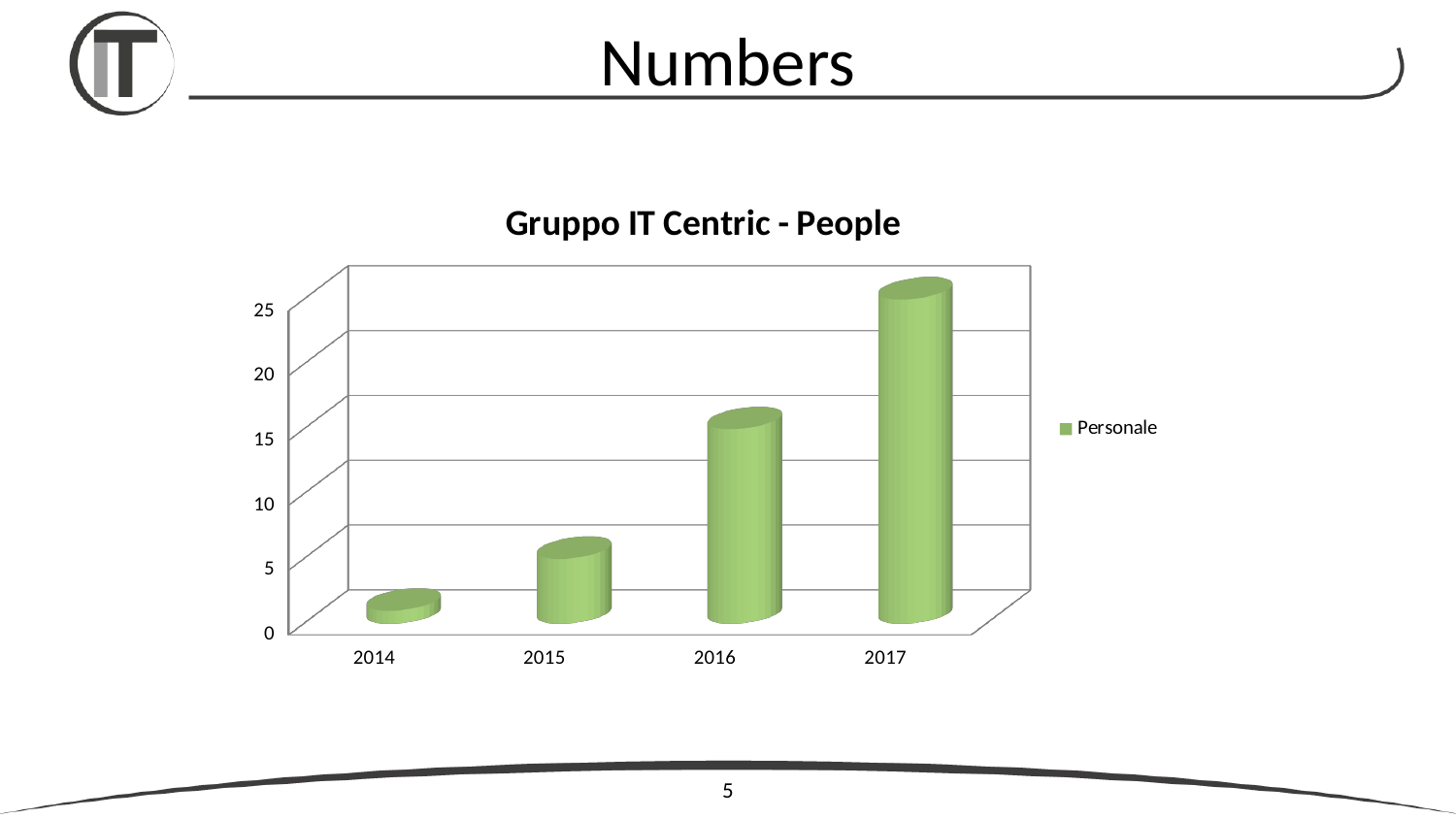
Which year has the highest value for Personale? 2017 What is the name of the series shown in the legend? Personale Is the value for 2016 greater or less than 10? greater What is the title of the chart? Gruppo IT Centric - People Is the value for 2014 greater or less than 5? less Do the values rise or fall from 2014 to 2017? rise Which year has the lowest value for Personale? 2014 How many series does the legend list? 1 Is the value for 2017 greater or less than 20? greater What kind of chart is shown on the slide? bar chart Which is larger, the value for 2015 or the value for 2016? 2016 How many years are shown on the x axis of the chart? 4